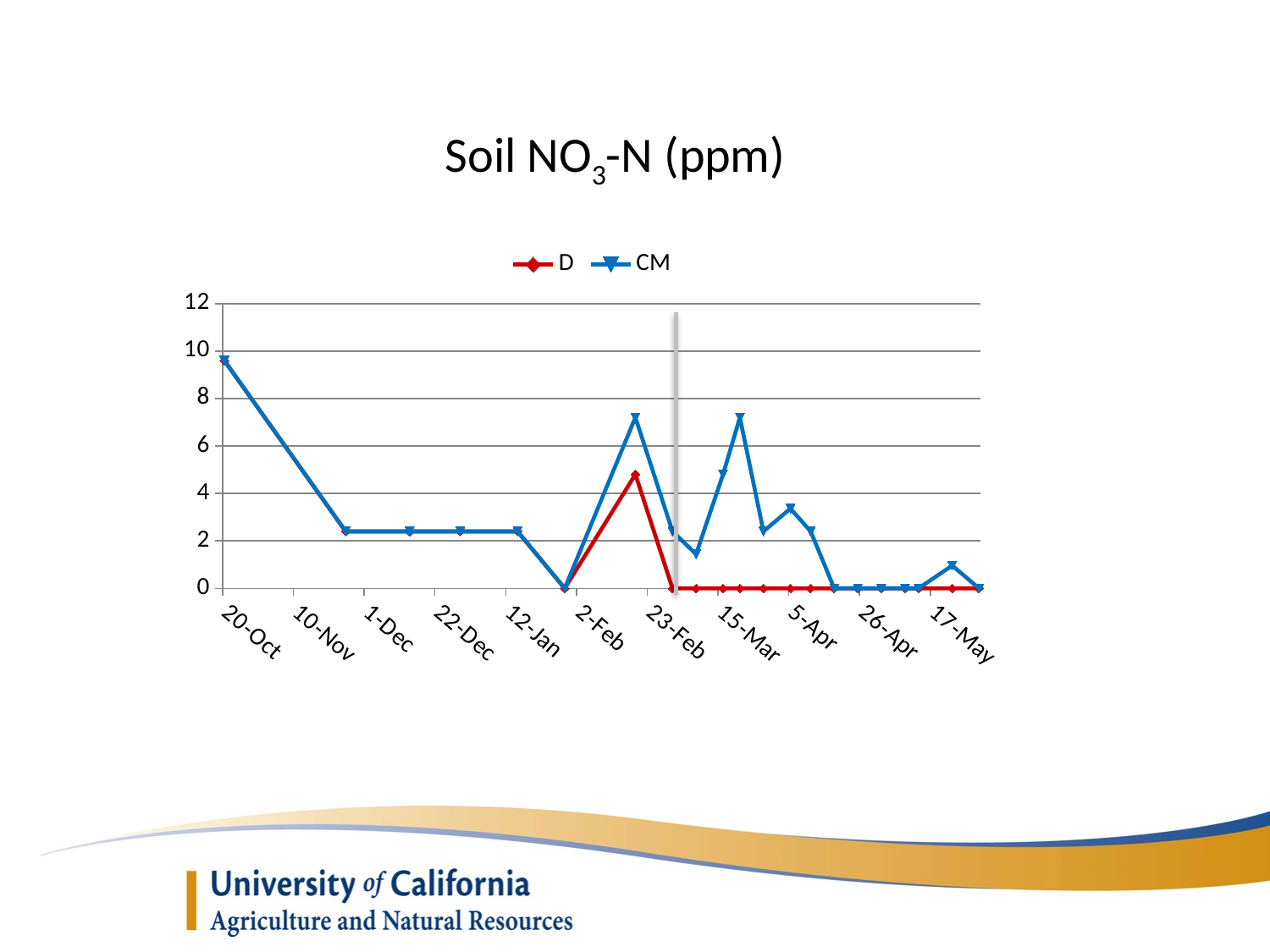
What are the two series named in the legend? D and CM Which series reaches the higher peak in early February, D or CM? CM Is the highest CM value after 23-Feb greater or less than 6? greater What kind of chart is shown on the slide? line chart What is the value for D at 17-May? 0 How many date labels are shown on the x axis? 11 How many series does the legend list? 2 Is the value for CM at 20-Oct greater or less than 8? greater What is the title of the chart? Soil NO3-N (ppm) Is the value for D at 20-Oct greater or less than 8? greater Do the values rise or fall from 20-Oct to 10-Nov? fall